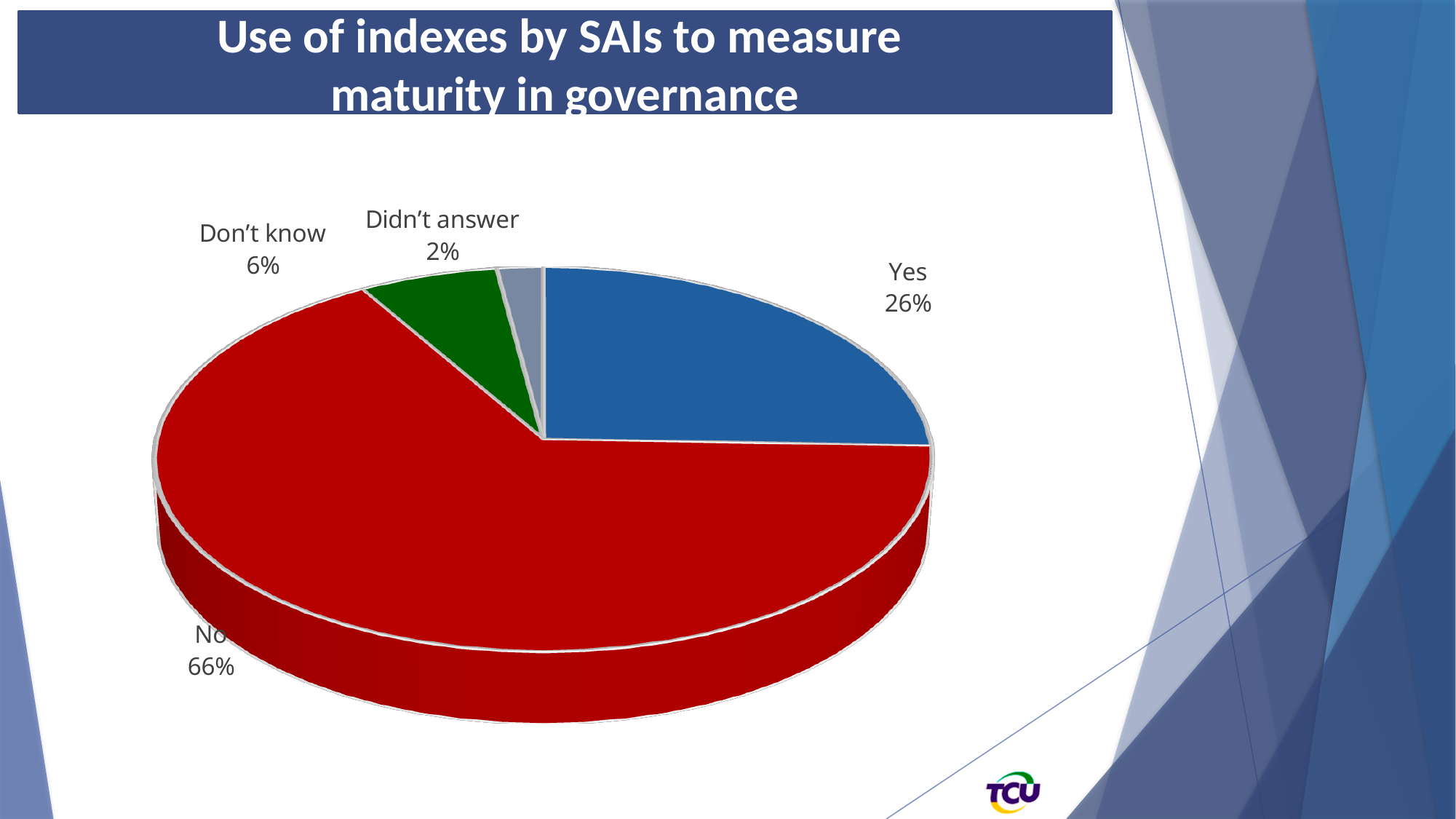
Which category has the smallest share of the pie? Didn't answer What kind of chart is shown on the slide? Pie chart What colour is the "No" slice? Red What is the difference in percentage points between "No" and "Yes"? 40 What percentage is shown for "Didn't answer"? 2% How many categories are shown in the pie chart? 4 What percentage is shown for "Don't know"? 6% What is the title of the slide containing the chart? Use of indexes by SAIs to measure maturity in governance What percentage of SAIs answered "No"? 66% Which is larger, the share for "Don't know" or the share for "Didn't answer"? Don't know What percentage of SAIs answered "Yes"? 26% Which category has the largest share of the pie? No